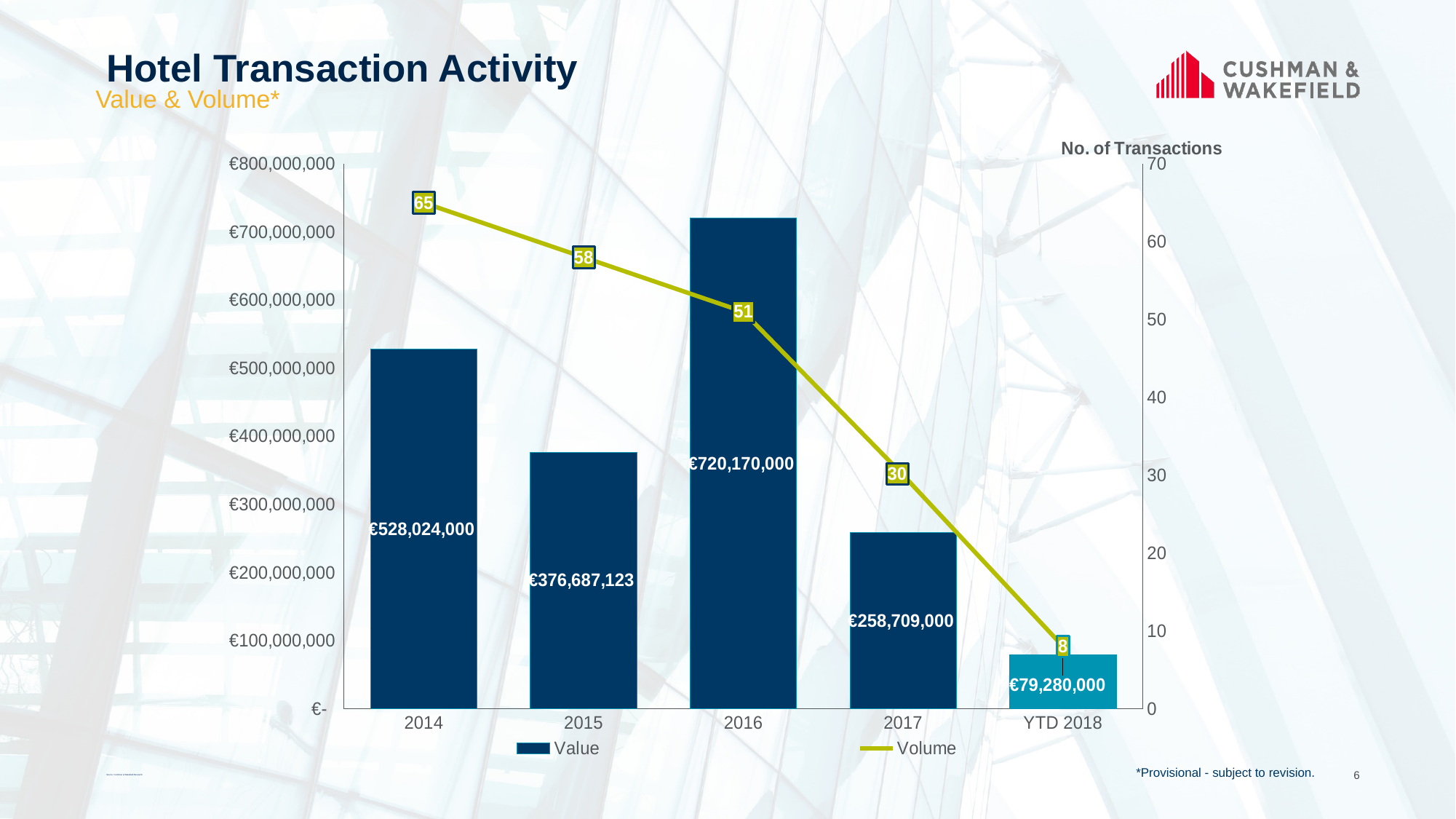
How many periods are shown on the x axis? 5 What is the difference in Volume between 2014 and 2017? 35 Is the transaction Value for 2017 greater or less than €300,000,000? less Which year has the highest transaction Value? 2016 What is the transaction Value for YTD 2018? €79,280,000 Does the Volume line rise or fall from 2014 to YTD 2018? fall What is the Volume (number of transactions) for 2015? 58 What is the transaction Value for 2016? €720,170,000 How many series does the legend list? 2 What is the title of the right-hand axis? No. of Transactions Which period has the lowest Volume of transactions? YTD 2018 Which is larger, the transaction Value for 2014 or for 2015? 2014